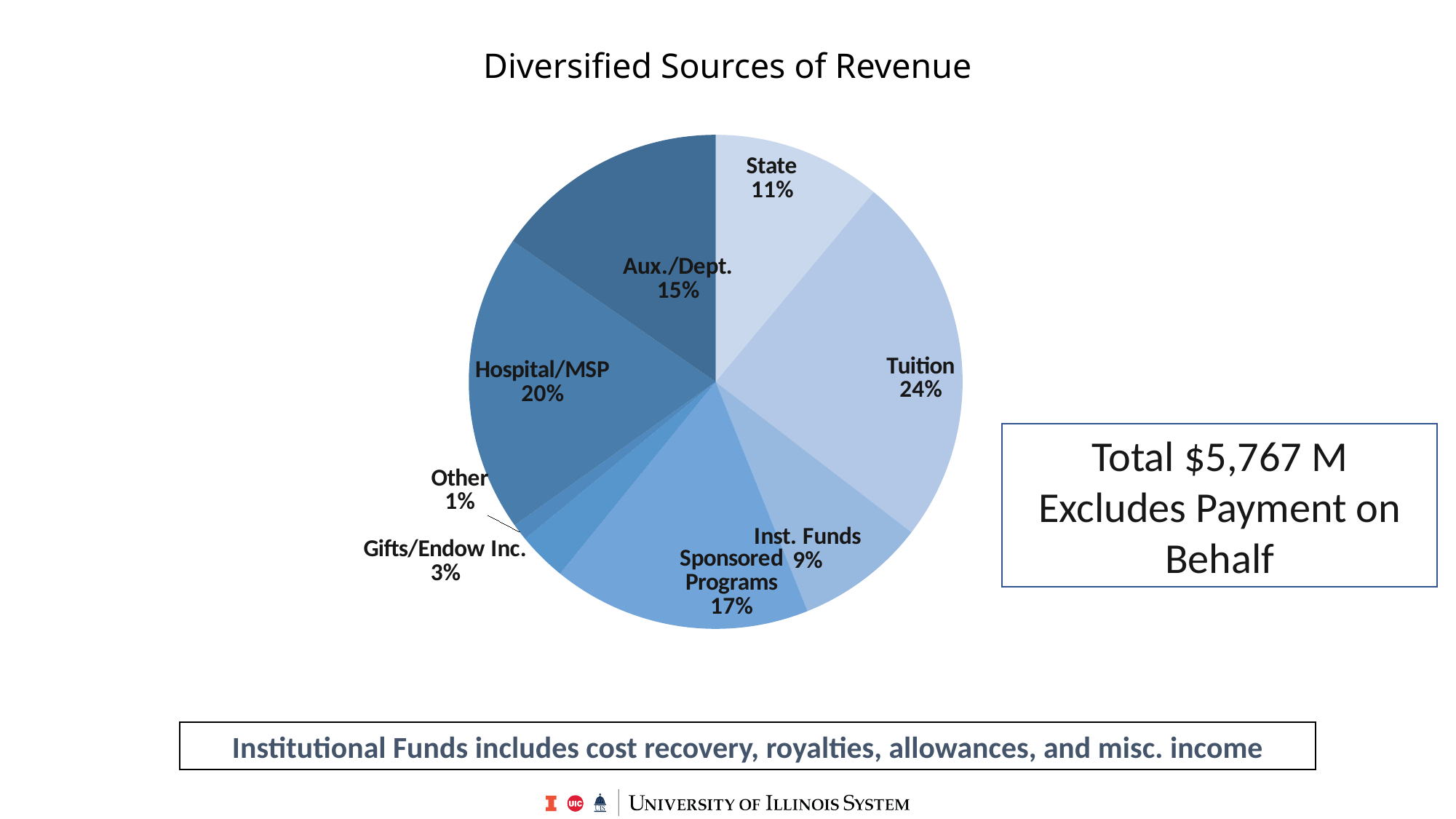
What share of revenue comes from Sponsored Programs? 17% What share of revenue comes from Tuition? 24% What kind of chart is shown on the slide? pie chart What total revenue amount is stated in the box next to the chart? $5,767 M What is the difference in percentage points between Tuition and State? 13 What share of revenue comes from Gifts/Endow Inc.? 3% What share of revenue comes from Hospital/MSP? 20% Which revenue source has the largest share of the pie? Tuition How many slices does the pie chart have? 8 Which revenue source has the smallest share of the pie? Other What is the title of the chart? Diversified Sources of Revenue Which is larger, the share for Aux./Dept. or the share for State? Aux./Dept.